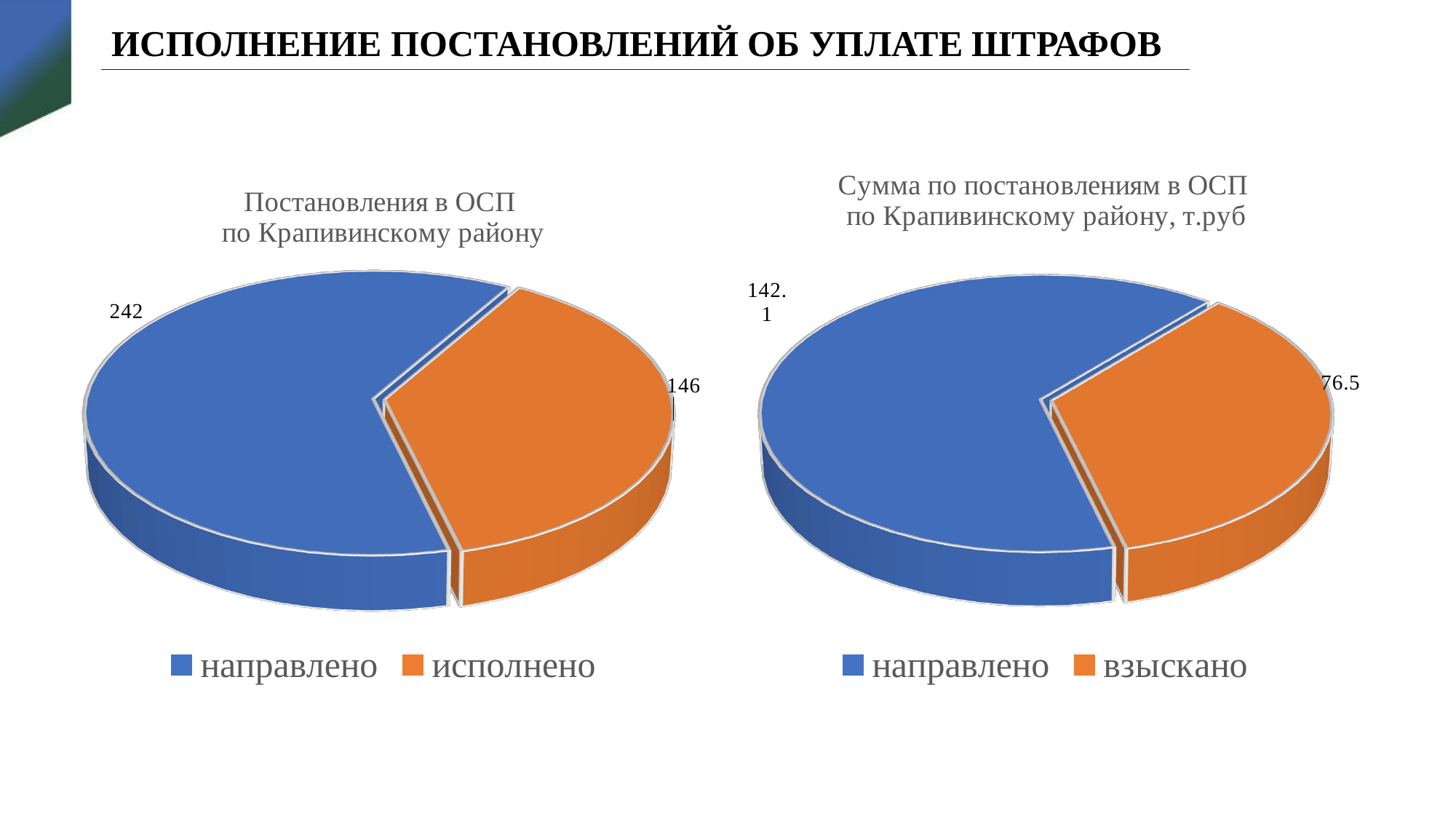
What type of chart is the left chart 'Постановления в ОСП по Крапивинскому району'? Pie chart In the right chart 'Сумма по постановлениям в ОСП по Крапивинскому району, т.руб', which category has the smallest slice? взыскано In the left chart 'Постановления в ОСП по Крапивинскому району', what is the value for 'направлено'? 242 In the left chart 'Постановления в ОСП по Крапивинскому району', what colour is the 'исполнено' slice? Orange In the right chart 'Сумма по постановлениям в ОСП по Крапивинскому району, т.руб', what is the value for 'взыскано'? 76.5 In the left chart 'Постановления в ОСП по Крапивинскому району', which category has the largest slice? направлено How many slices does the right chart 'Сумма по постановлениям в ОСП по Крапивинскому району, т.руб' have? 2 In the left chart 'Постановления в ОСП по Крапивинскому району', what is the difference between 'направлено' and 'исполнено'? 96 In the right chart 'Сумма по постановлениям в ОСП по Крапивинскому району, т.руб', what is the difference between 'направлено' and 'взыскано'? 65.6 In the left chart 'Постановления в ОСП по Крапивинскому району', what is the value for 'исполнено'? 146 In the right chart 'Сумма по постановлениям в ОСП по Крапивинскому району, т.руб', what is the value for 'направлено'? 142.1 In the right chart 'Сумма по постановлениям в ОСП по Крапивинскому району, т.руб', which is larger: 'направлено' or 'взыскано'? направлено